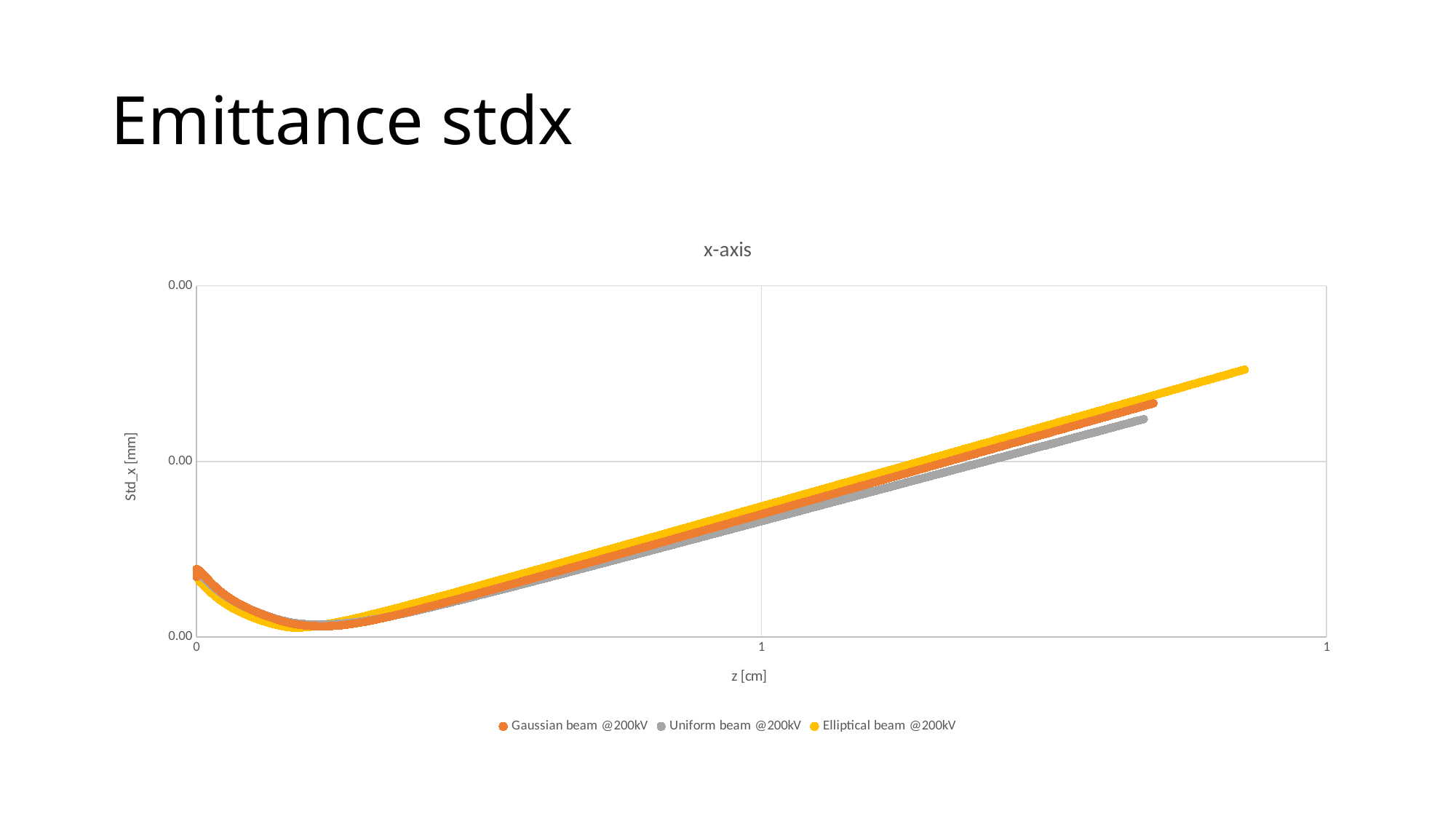
Which series extends furthest along the z axis? Elliptical beam @200kV What kind of chart is shown on the slide? Scatter chart What is the title of the chart? x-axis How many series does the legend list? 3 Over most of the z range, do the Std_x values rise or fall as z increases? Rise At the right end of the chart, which series ends higher: Gaussian beam @200kV or Uniform beam @200kV? Gaussian beam @200kV Which series reaches the highest Std_x value at the right end of the chart? Elliptical beam @200kV What is the label of the vertical axis? Std_x [mm] Which series ends at the lowest Std_x value at the right end of the chart? Uniform beam @200kV